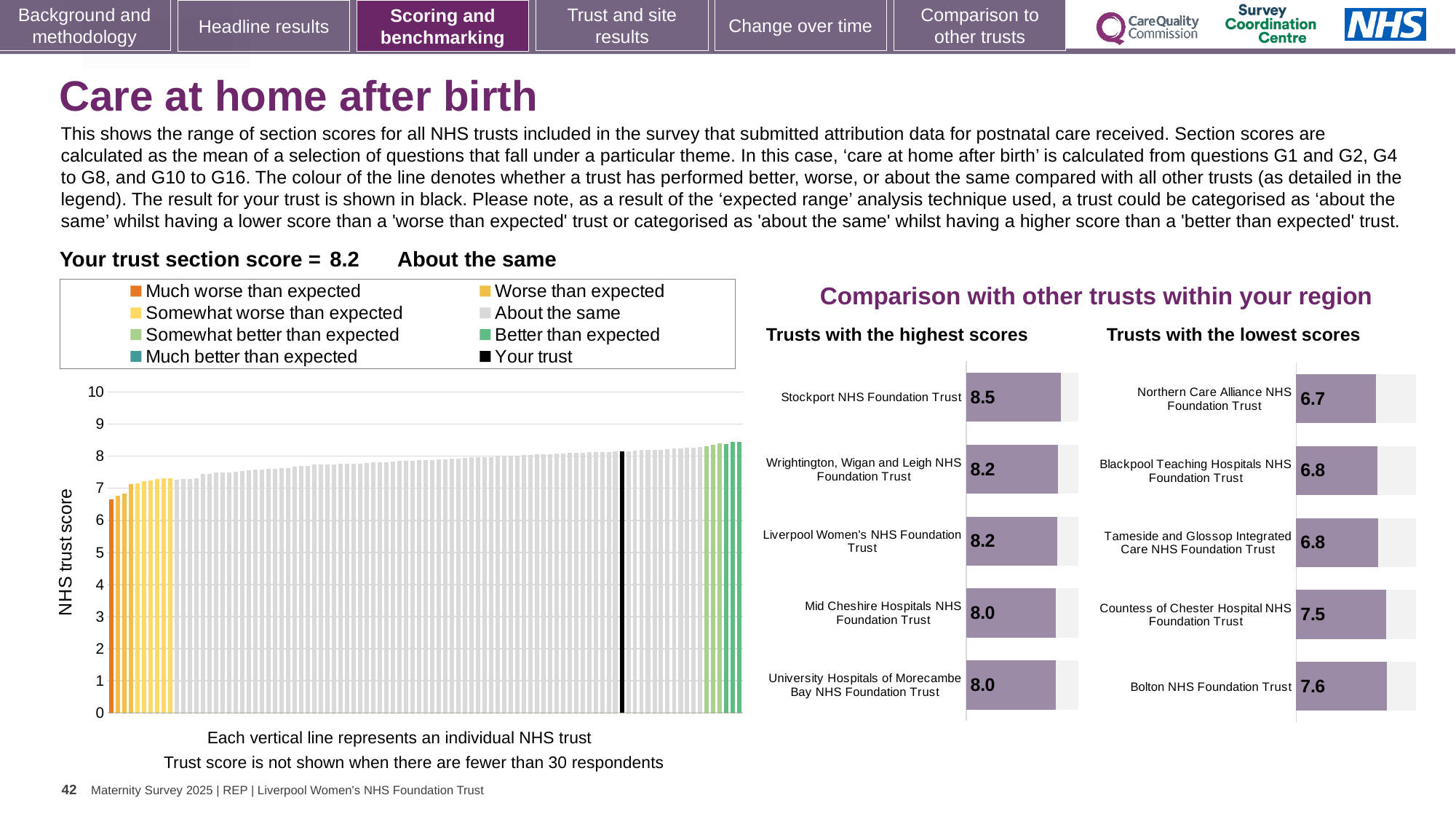
In the 'Trusts with the highest scores' chart, which trust has the highest score? Stockport NHS Foundation Trust In the 'Trusts with the highest scores' chart, what is the score for Stockport NHS Foundation Trust? 8.5 In the 'Trusts with the lowest scores' chart, which trust has the lowest score? Northern Care Alliance NHS Foundation Trust In the 'Trusts with the lowest scores' chart, what is the score for Northern Care Alliance NHS Foundation Trust? 6.7 In the main 'NHS trust score' chart, is the value of the lowest bar greater or less than 7? less What kind of chart is the main 'NHS trust score' chart on the left? Bar chart In the 'Trusts with the lowest scores' chart, which has the larger score: Countess of Chester Hospital NHS Foundation Trust or Bolton NHS Foundation Trust? Bolton NHS Foundation Trust How many trusts are shown in the 'Trusts with the highest scores' chart? 5 How many entries does the legend of the main 'NHS trust score' chart list? 8 In the main 'NHS trust score' chart, do the values rise or fall from left to right? Rise In the 'Trusts with the highest scores' chart, what is the difference between the scores of Stockport NHS Foundation Trust and University Hospitals of Morecambe Bay NHS Foundation Trust? 0.5 In the main 'NHS trust score' chart, what colour is the bar for your trust? Black